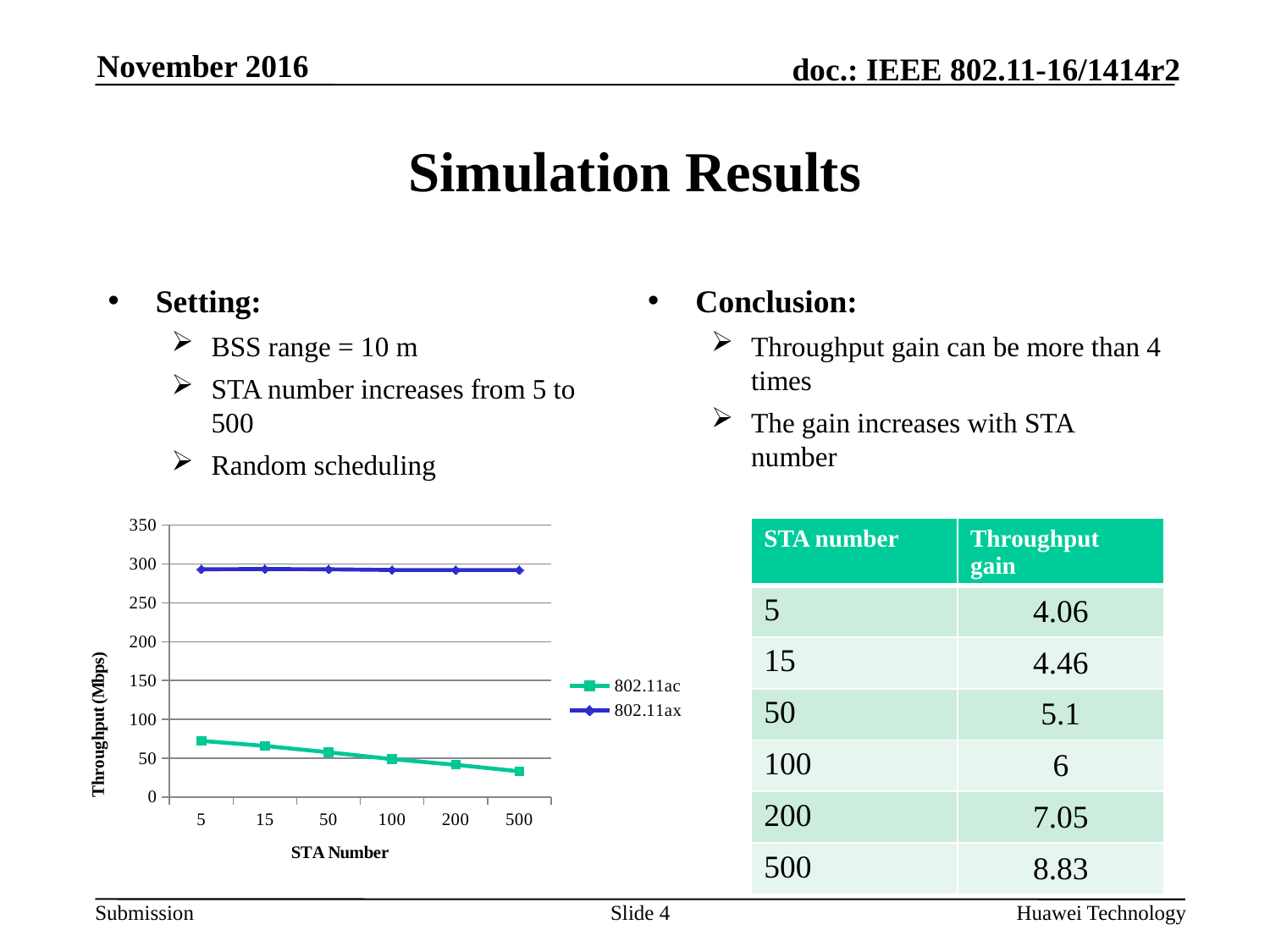
How many series does the chart legend list? 2 At STA Number 200, which series has the higher throughput, 802.11ac or 802.11ax? 802.11ax At which STA Number is the 802.11ac throughput highest? 5 What is the title of the chart's vertical axis? Throughput (Mbps) What kind of chart is shown on the slide? line chart How many STA Number categories are plotted along the x axis of the chart? 6 At which STA Number is the 802.11ac throughput lowest? 500 Which two series are listed in the chart legend? 802.11ac and 802.11ax Does the 802.11ac throughput rise or fall as the STA Number increases along the x axis? fall Is the 802.11ac throughput at STA Number 500 greater or less than 50? less Is the 802.11ac throughput at STA Number 5 greater or less than 50? greater Is the 802.11ax throughput at STA Number 100 greater or less than 250? greater